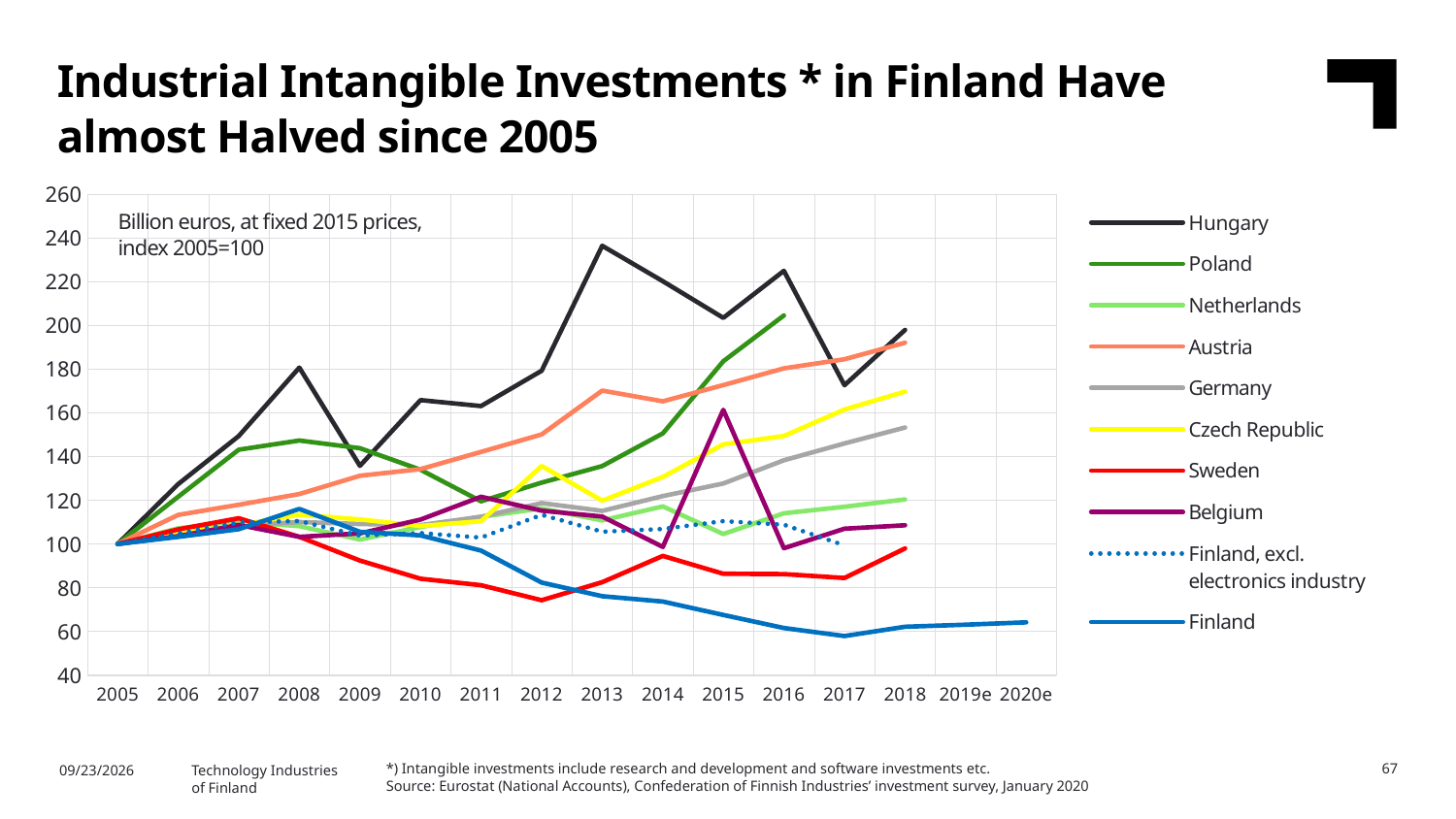
Is the value for Finland in 2016 greater or less than 80? less Which country has the highest value in 2013? Hungary What kind of chart is shown on the slide? line chart Does the Finland line rise or fall from 2005 to 2018? fall Is the value for Austria in 2018 greater or less than 180? greater In 2016, which is larger, the value for Poland or the value for Netherlands? Poland How many years are labelled on the x axis? 16 What is the index value for all countries in 2005? 100 Which series is drawn with a dotted line? Finland, excl. electronics industry Which series has the lowest value in 2018? Finland How many series does the legend list? 10 Is the value for Hungary in 2013 greater or less than 220? greater